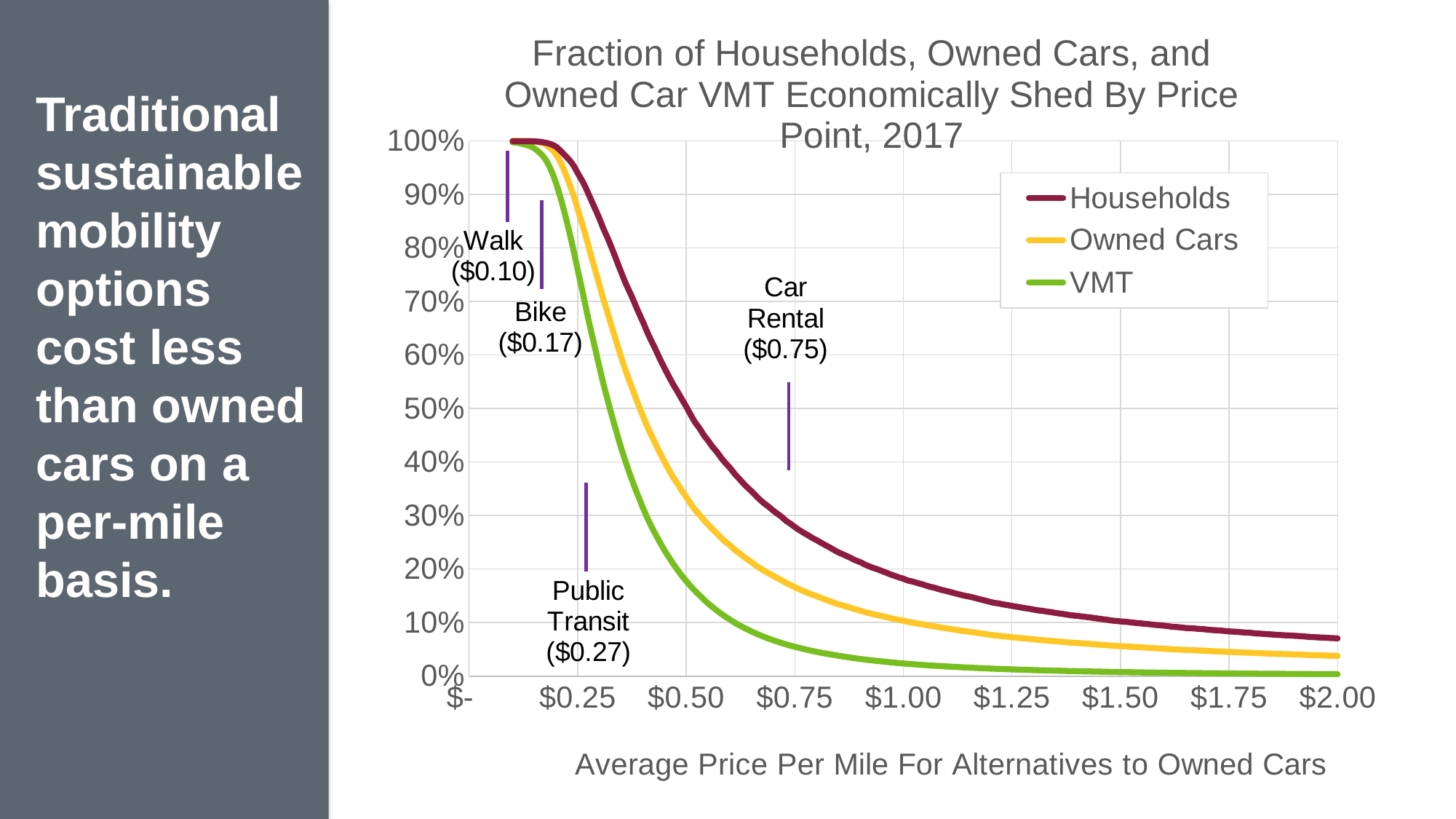
Is the Households value at $1.00 greater or less than 10%? greater At $0.50 per mile, which series is higher, Owned Cars or VMT? Owned Cars Which series is the lowest at $1.00 per mile? VMT How many series does the legend list? 3 Do the plotted values rise or fall as the average price per mile increases? fall At $1.00 per mile, which series is higher, Households or VMT? Households Is the VMT value at $0.50 greater or less than 30%? less What kind of chart is shown on the slide? line chart What price per mile is annotated for Public Transit? $0.27 What is the label of the x axis? Average Price Per Mile For Alternatives to Owned Cars What price per mile is annotated for Car Rental? $0.75 Is the Owned Cars value at $0.75 greater or less than 30%? less